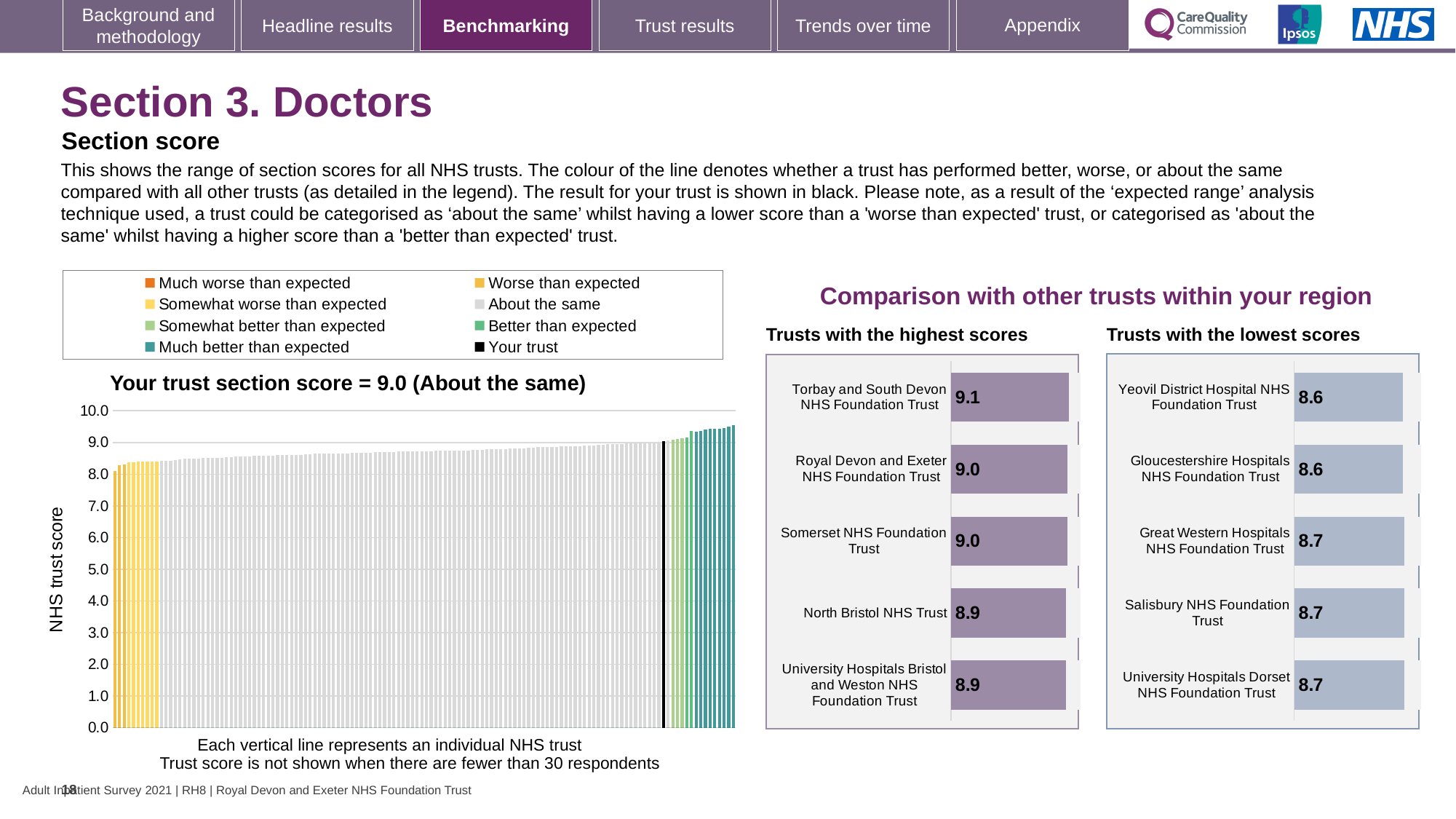
In the 'Trusts with the highest scores' chart, how many trusts are listed? 5 In the 'Trusts with the highest scores' chart, what is the difference between the scores of Torbay and South Devon NHS Foundation Trust and North Bristol NHS Trust? 0.2 In the 'Your trust section score' chart, what is the label on the vertical axis? NHS trust score In the 'Trusts with the highest scores' chart, which trust has the highest score? Torbay and South Devon NHS Foundation Trust In the 'Trusts with the lowest scores' chart, what is the score for Salisbury NHS Foundation Trust? 8.7 Which has the larger score: Torbay and South Devon NHS Foundation Trust in the 'Trusts with the highest scores' chart or Great Western Hospitals NHS Foundation Trust in the 'Trusts with the lowest scores' chart? Torbay and South Devon NHS Foundation Trust In the 'Trusts with the lowest scores' chart, what is the score for Yeovil District Hospital NHS Foundation Trust? 8.6 In the 'Your trust section score' chart, is the value for the highest-scoring trust greater or less than 10.0? less In the 'Your trust section score' chart, what kind of chart is shown? bar chart In the 'Trusts with the highest scores' chart, what is the score for Torbay and South Devon NHS Foundation Trust? 9.1 In the 'Your trust section score' chart, what is the section score for your trust? 9.0 How many entries does the legend above the 'Your trust section score' chart list? 8